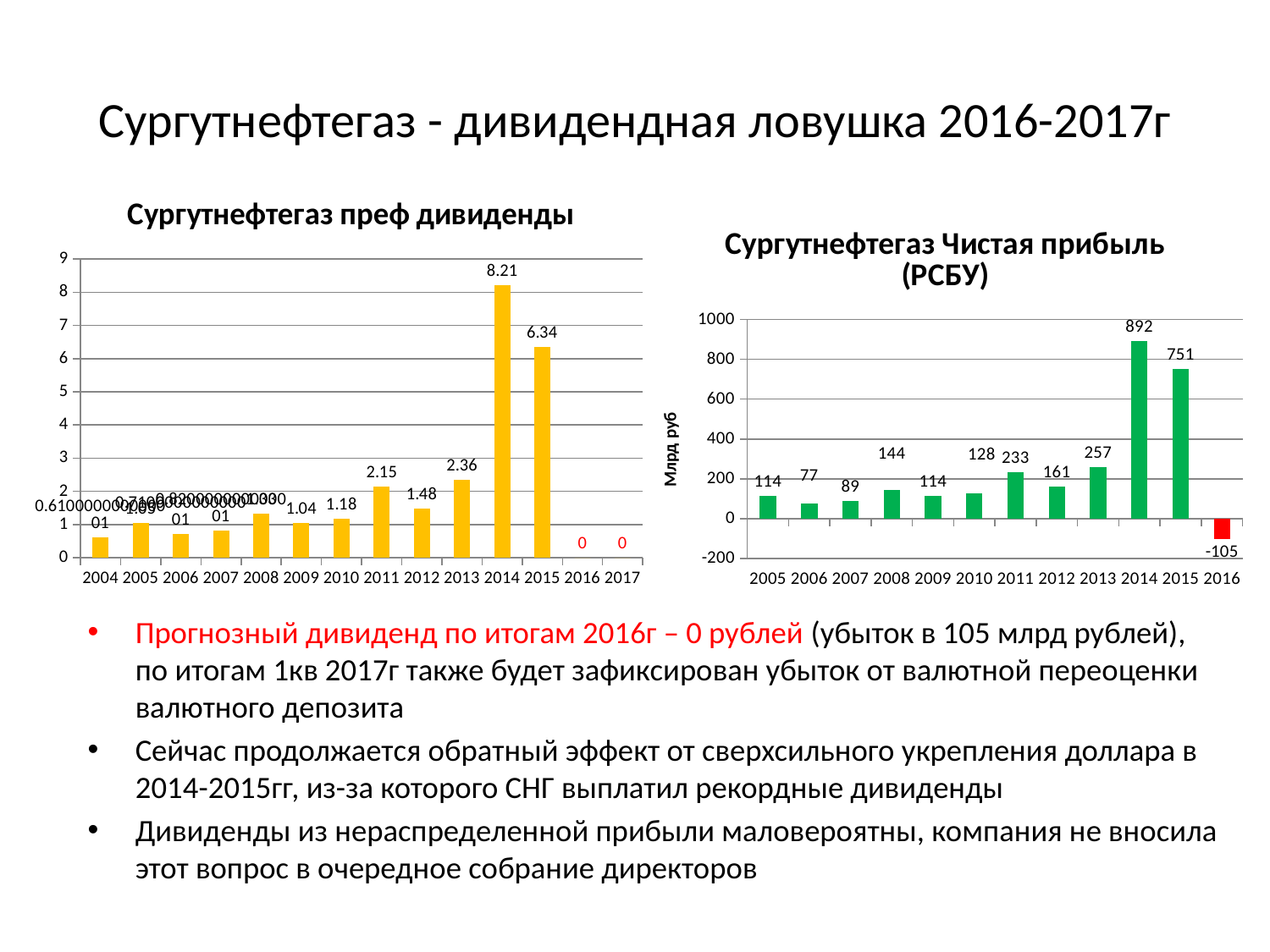
How many years are shown in the 'Сургутнефтегаз Чистая прибыль (РСБУ)' chart? 12 In the 'Сургутнефтегаз преф дивиденды' chart, which year has the highest value? 2014 In the 'Сургутнефтегаз Чистая прибыль (РСБУ)' chart, what is the value for 2014? 892 In the 'Сургутнефтегаз преф дивиденды' chart, what is the value for 2014? 8.21 In the 'Сургутнефтегаз Чистая прибыль (РСБУ)' chart, what is the difference between the values for 2014 and 2015? 141 In the 'Сургутнефтегаз преф дивиденды' chart, what is the value for 2016? 0 In the 'Сургутнефтегаз преф дивиденды' chart, what is the difference between the values for 2014 and 2015? 1.87 In the 'Сургутнефтегаз преф дивиденды' chart, which is larger, the value for 2011 or the value for 2012? 2011 In the 'Сургутнефтегаз преф дивиденды' chart, what is the value for 2015? 6.34 In the 'Сургутнефтегаз Чистая прибыль (РСБУ)' chart, what is the value for 2016? -105 What type of chart is the 'Сургутнефтегаз Чистая прибыль (РСБУ)' chart? Bar chart In the 'Сургутнефтегаз Чистая прибыль (РСБУ)' chart, which year has the lowest value? 2016